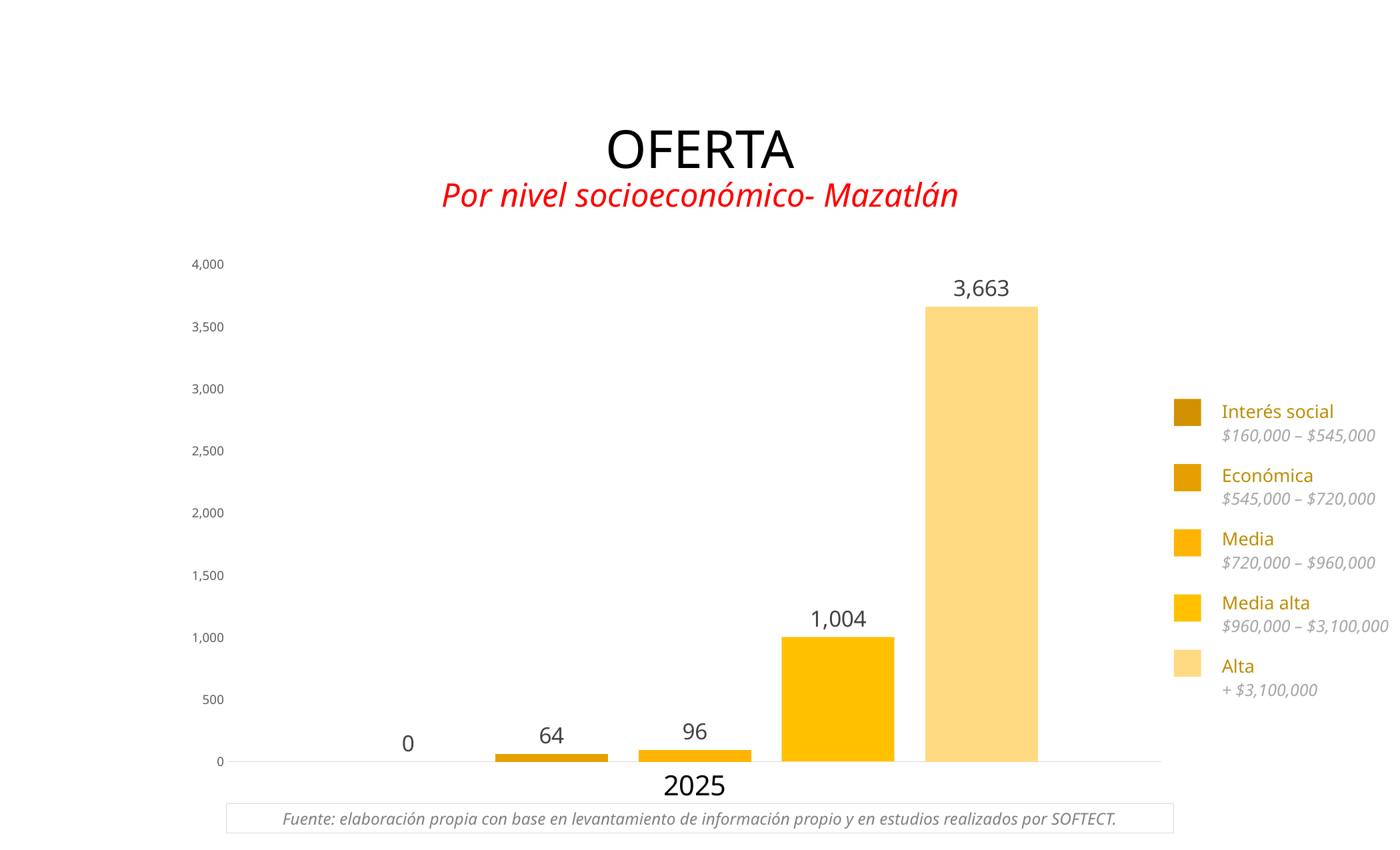
What is the value for Alta in 2025? 3,663 What kind of chart is shown on the slide? Bar chart Which socioeconomic level has the lowest value in 2025? Interés social What is the value for Media alta in 2025? 1,004 How many series does the legend list? 5 What is the value for Económica in 2025? 64 What is the difference between the values for Alta and Media alta? 2,659 Which socioeconomic level has the highest value in 2025? Alta What price range does the legend give for the Media alta level? $960,000 – $3,100,000 Which is larger, the value for Media or the value for Económica? Media What is the difference between the values for Media and Económica? 32 What is the value for Interés social in 2025? 0